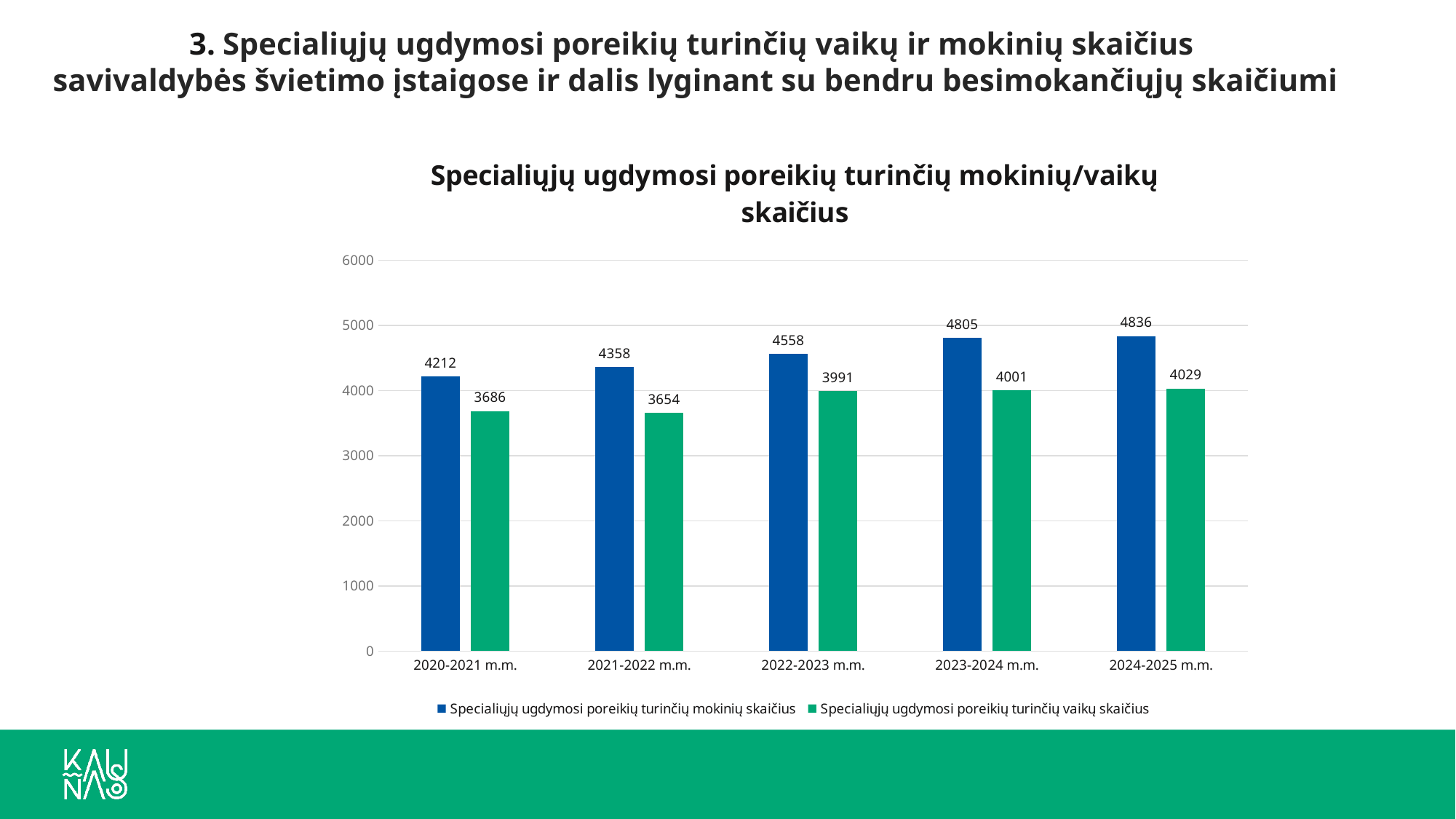
In which school year is 'Specialiųjų ugdymosi poreikių turinčių vaikų skaičius' lowest? 2021-2022 m.m. What is the difference between 'Specialiųjų ugdymosi poreikių turinčių mokinių skaičius' and 'Specialiųjų ugdymosi poreikių turinčių vaikų skaičius' in 2024-2025 m.m.? 807 Is the value for 'Specialiųjų ugdymosi poreikių turinčių vaikų skaičius' in 2023-2024 m.m. greater or less than 5000? less What is the value for 'Specialiųjų ugdymosi poreikių turinčių mokinių skaičius' in 2022-2023 m.m.? 4558 What kind of chart is shown on the slide? bar chart Which is larger in 2020-2021 m.m.: 'Specialiųjų ugdymosi poreikių turinčių mokinių skaičius' or 'Specialiųjų ugdymosi poreikių turinčių vaikų skaičius'? Specialiųjų ugdymosi poreikių turinčių mokinių skaičius In which school year is 'Specialiųjų ugdymosi poreikių turinčių mokinių skaičius' highest? 2024-2025 m.m. What is the value for 'Specialiųjų ugdymosi poreikių turinčių vaikų skaičius' in 2021-2022 m.m.? 3654 Does 'Specialiųjų ugdymosi poreikių turinčių mokinių skaičius' rise or fall from 2020-2021 m.m. to 2024-2025 m.m.? rise How many school years are shown on the x axis? 5 What colour are the bars for 'Specialiųjų ugdymosi poreikių turinčių vaikų skaičius'? green How many series does the legend list? 2